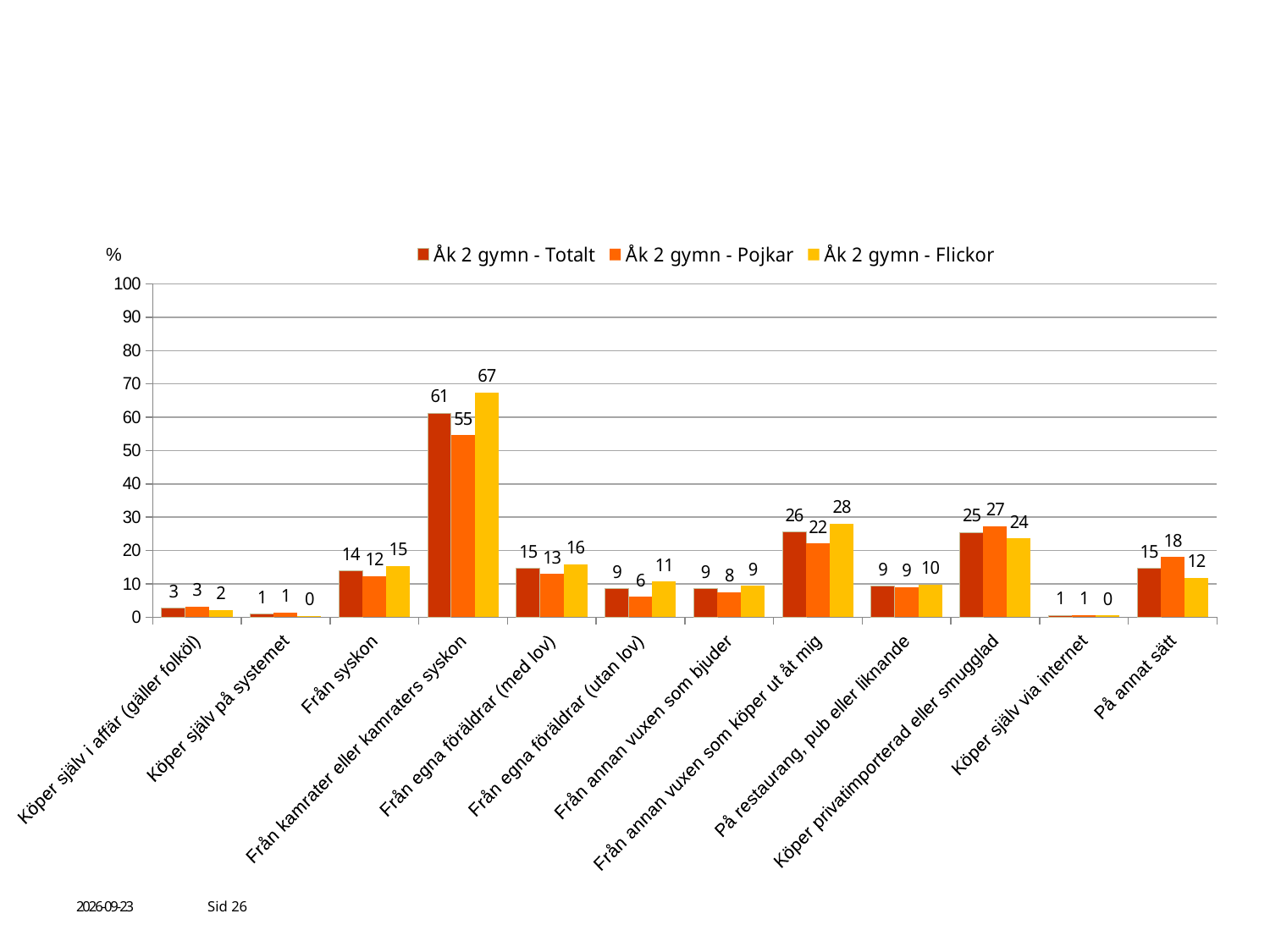
Which is larger in the category "På annat sätt": the value for "Åk 2 gymn - Pojkar" or for "Åk 2 gymn - Flickor"? Åk 2 gymn - Pojkar Which category has the highest value for "Åk 2 gymn - Totalt"? Från kamrater eller kamraters syskon What is the value for "Åk 2 gymn - Flickor" in the category "Köper själv via internet"? 0 Is the value for "Åk 2 gymn - Totalt" in the category "Från kamrater eller kamraters syskon" greater or less than 50? greater How many categories are shown on the x axis of the chart? 12 What is the value for "Åk 2 gymn - Totalt" in the category "Köper privatimporterad eller smugglad"? 25 What is the value for "Åk 2 gymn - Pojkar" in the category "Från annan vuxen som köper ut åt mig"? 22 What is the value for "Åk 2 gymn - Flickor" in the category "Från kamrater eller kamraters syskon"? 67 How many series does the legend list? 3 What kind of chart is shown on the slide? Bar chart What unit is shown at the top of the y axis? % What is the difference between the "Åk 2 gymn - Flickor" and "Åk 2 gymn - Pojkar" values in the category "Från kamrater eller kamraters syskon"? 12